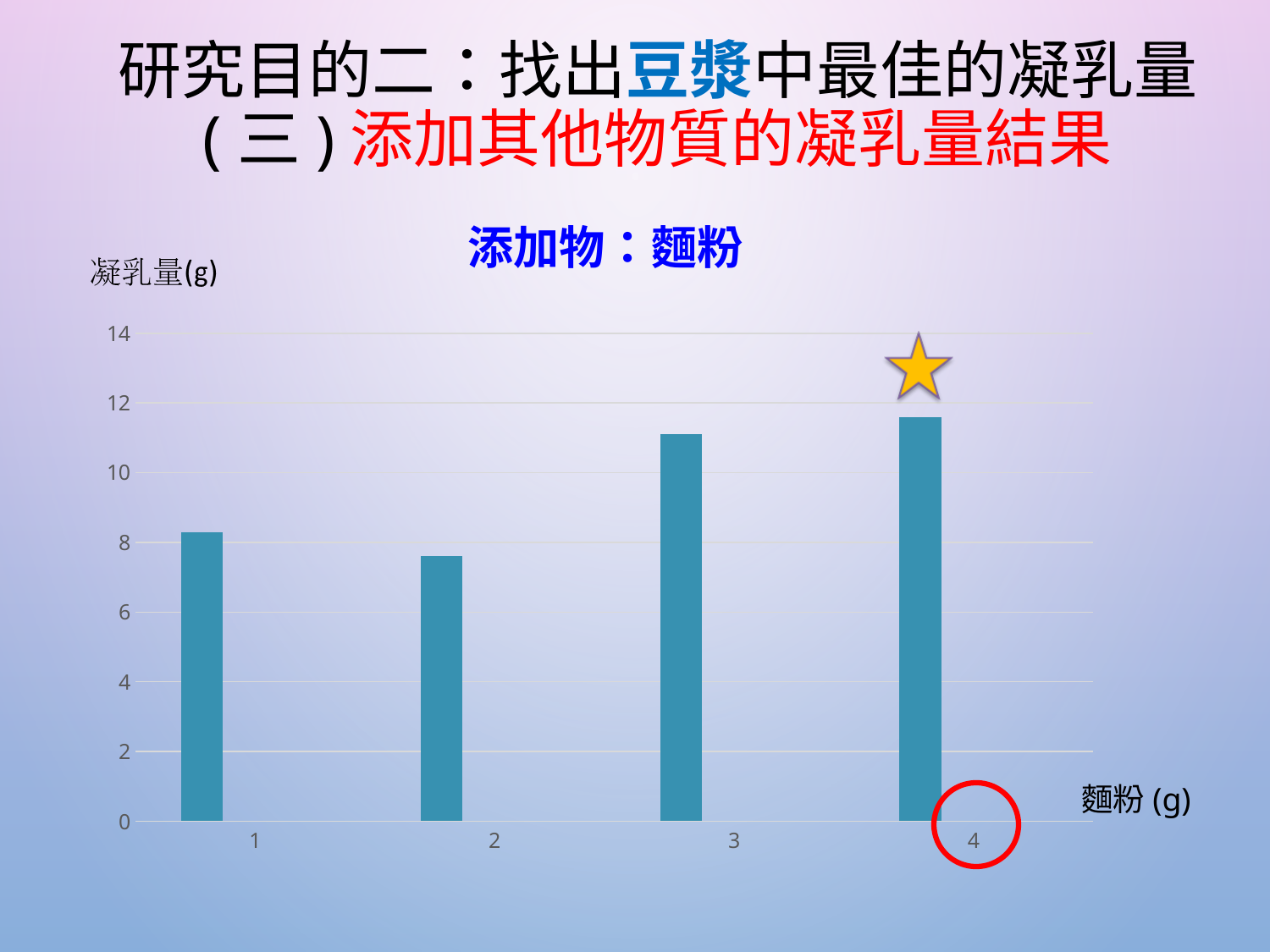
Which has a larger 凝乳量: 1 g of 麵粉 or 2 g of 麵粉? 1 g Is the 凝乳量 for 2 g of 麵粉 greater or less than 8? less Do the values rise or fall from 2 g to 4 g of 麵粉? rise What is the label of the vertical axis? 凝乳量(g) Which amount of 麵粉 (g) gives the highest 凝乳量? 4 Is the 凝乳量 for 4 g of 麵粉 greater or less than 12? less What is the title of the chart? 添加物：麵粉 Is the 凝乳量 for 3 g of 麵粉 greater or less than 10? greater What kind of chart is shown on the slide? bar chart Which amount of 麵粉 (g) gives the lowest 凝乳量? 2 How many bars (categories) are plotted in the chart? 4